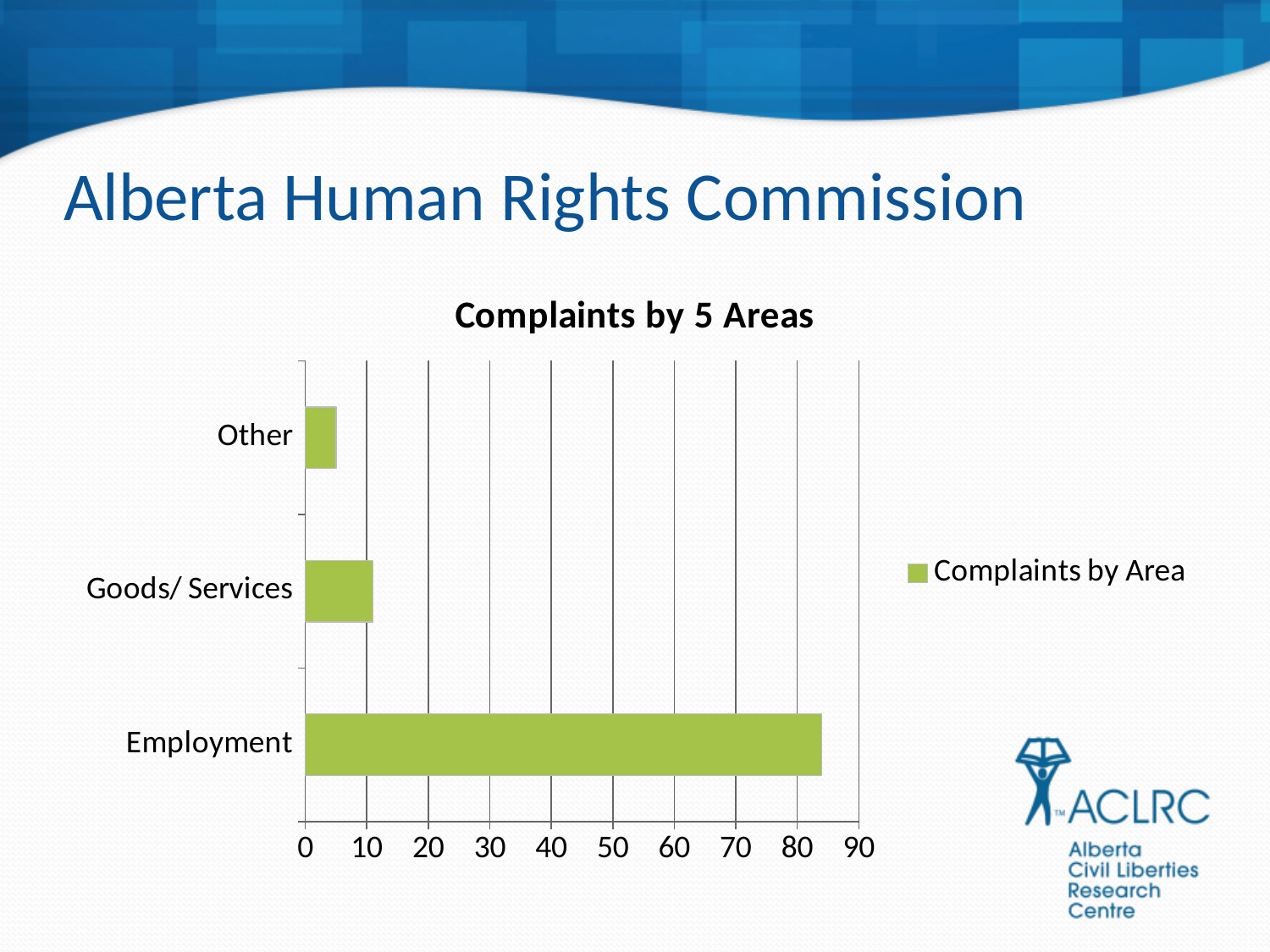
Which category has the highest value? Employment Which is larger, the value for Employment or the value for Goods/ Services? Employment How many categories are plotted in the chart? 3 What is the name of the series shown in the legend? Complaints by Area How many series does the legend list? 1 What is the title of the chart? Complaints by 5 Areas Is the value for Other greater or less than 10? less What kind of chart is shown on the slide? bar chart Which category has the lowest value? Other Is the value for Employment greater or less than 80? greater Which is larger, the value for Goods/ Services or the value for Other? Goods/ Services Is the value for Goods/ Services greater or less than 20? less